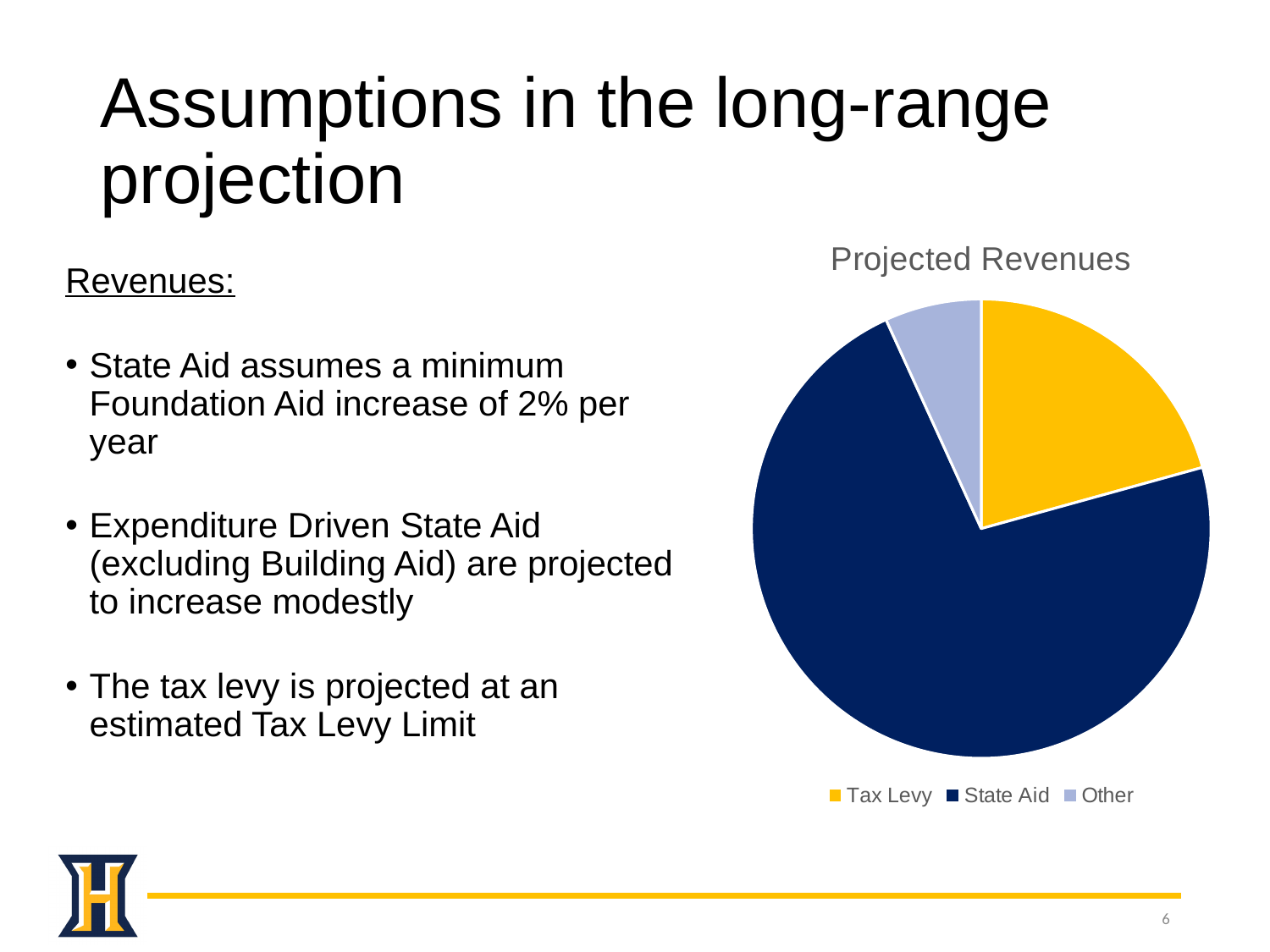
Which category has the smallest slice of the pie? Other Which is larger, the State Aid slice or the Tax Levy slice? State Aid Which is larger, the Tax Levy slice or the Other slice? Tax Levy What is the title of the chart? Projected Revenues Does the State Aid slice make up more or less than half of the pie? more Which category has the largest slice of the pie? State Aid How many slices does the pie chart have? 3 Which category is shown in yellow in the pie chart? Tax Levy What kind of chart is shown on the slide? pie chart How many entries does the chart's legend list? 3